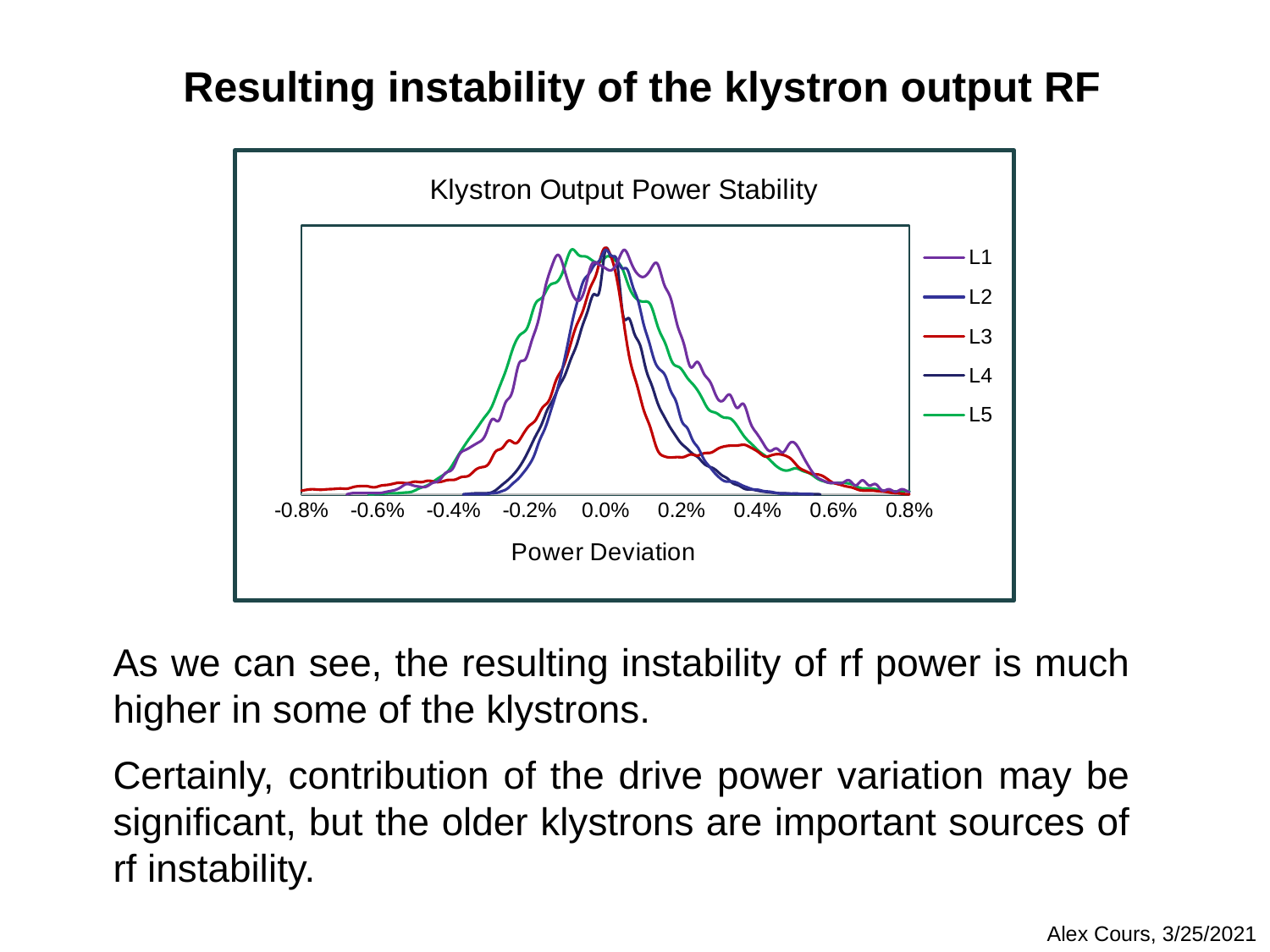
How many series does the legend of the chart list? 5 What is the title of the chart? Klystron Output Power Stability What is the leftmost tick label on the x axis of the chart? -0.8% What is the tick label at the centre of the x axis of the chart? 0.0% What is the rightmost tick label on the x axis of the chart? 0.8% What kind of chart is shown on the slide? line chart What is the label of the x axis of the chart? Power Deviation How many tick labels are shown on the x axis of the chart? 9